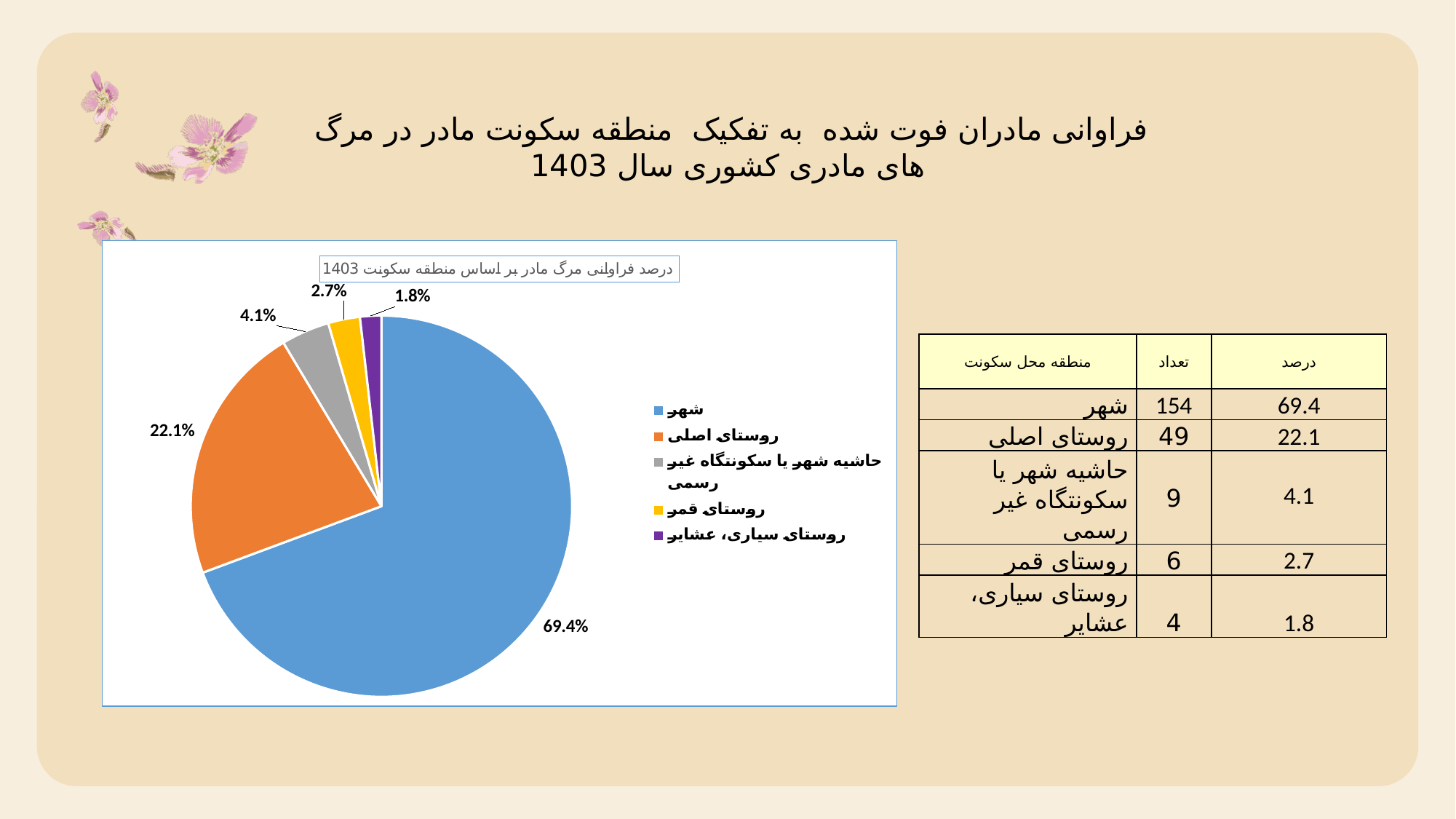
Which category has the smallest slice of the pie chart? روستای سیاری، عشایر What is the percentage shown for the روستای اصلی slice? 22.1% What is the percentage shown for the روستای سیاری، عشایر slice? 1.8% How many categories does the pie chart legend list? 5 What colour is the شهر slice in the pie chart? blue Which category has the largest slice of the pie chart? شهر Which slice is larger: روستای قمر or حاشیه شهر یا سکونتگاه غیر رسمی? حاشیه شهر یا سکونتگاه غیر رسمی What is the difference in percentage points between the شهر slice and the روستای اصلی slice? 47.3 What is the percentage shown for the روستای قمر slice? 2.7% What type of chart is shown on the slide? pie chart What is the percentage shown for the حاشیه شهر یا سکونتگاه غیر رسمی slice? 4.1% What is the percentage shown for the شهر slice of the pie chart? 69.4%